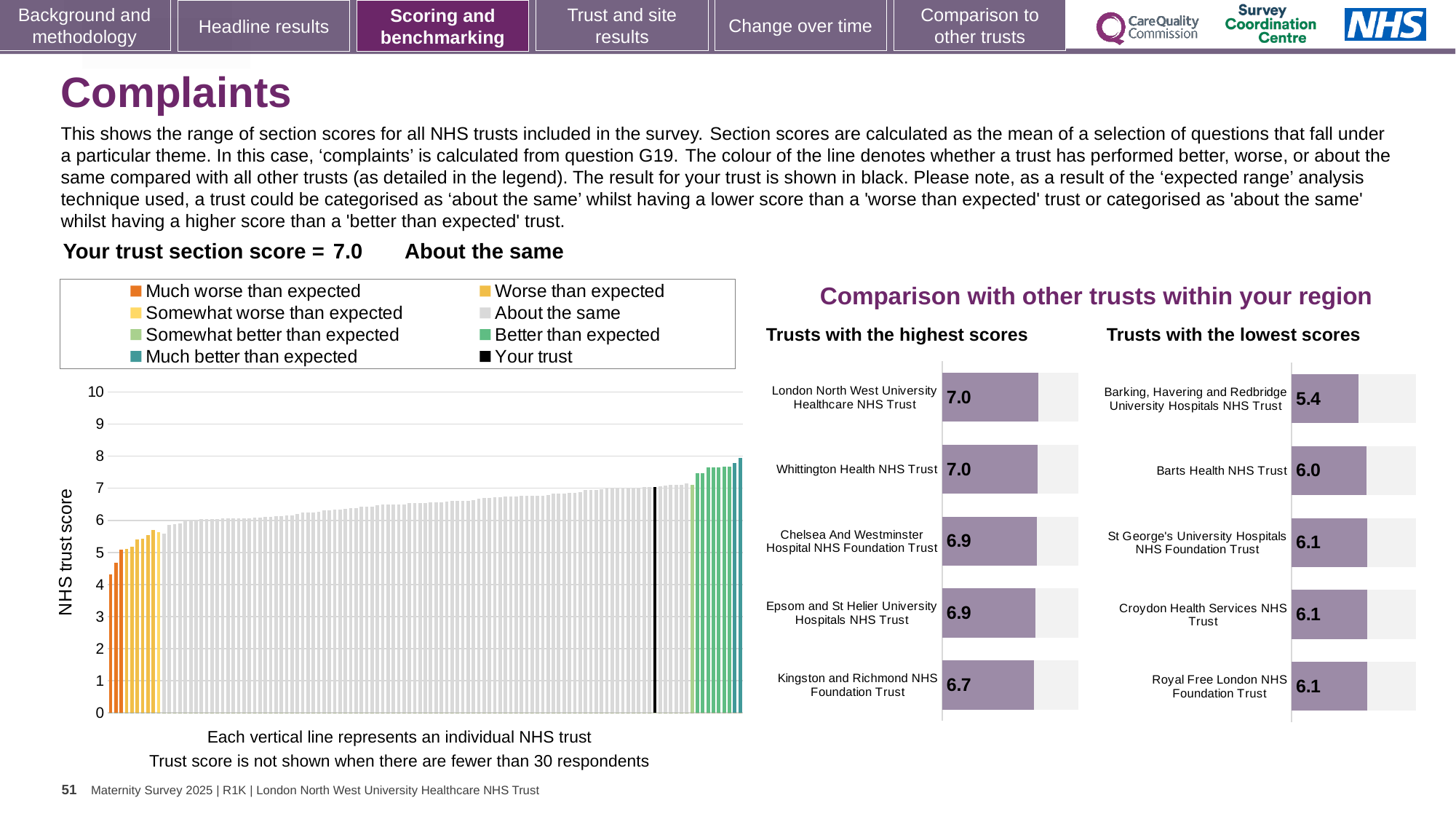
In the 'Trusts with the lowest scores' chart, which trust has the lowest score? Barking, Havering and Redbridge University Hospitals NHS Trust How many trusts are listed in the 'Trusts with the lowest scores' chart? 5 In the 'Trusts with the highest scores' chart, which trust has the lowest score shown? Kingston and Richmond NHS Foundation Trust What type of chart is the large chart on the left showing NHS trust scores? Bar chart In the 'Trusts with the highest scores' chart, what is the score for Chelsea And Westminster Hospital NHS Foundation Trust? 6.9 Which has a higher score: Kingston and Richmond NHS Foundation Trust in the highest-scores chart or Royal Free London NHS Foundation Trust in the lowest-scores chart? Kingston and Richmond NHS Foundation Trust In the 'Trusts with the highest scores' chart, what is the score for Kingston and Richmond NHS Foundation Trust? 6.7 In the large chart on the left, do the trust scores rise or fall from left to right? Rise In the 'Trusts with the lowest scores' chart, what is the score for Barts Health NHS Trust? 6.0 How many entries does the legend of the large chart on the left list? 8 In the 'Trusts with the highest scores' chart, what is the difference between the scores of Whittington Health NHS Trust and Kingston and Richmond NHS Foundation Trust? 0.3 In the 'Trusts with the lowest scores' chart, what is the difference between the scores of Barts Health NHS Trust and Barking, Havering and Redbridge University Hospitals NHS Trust? 0.6